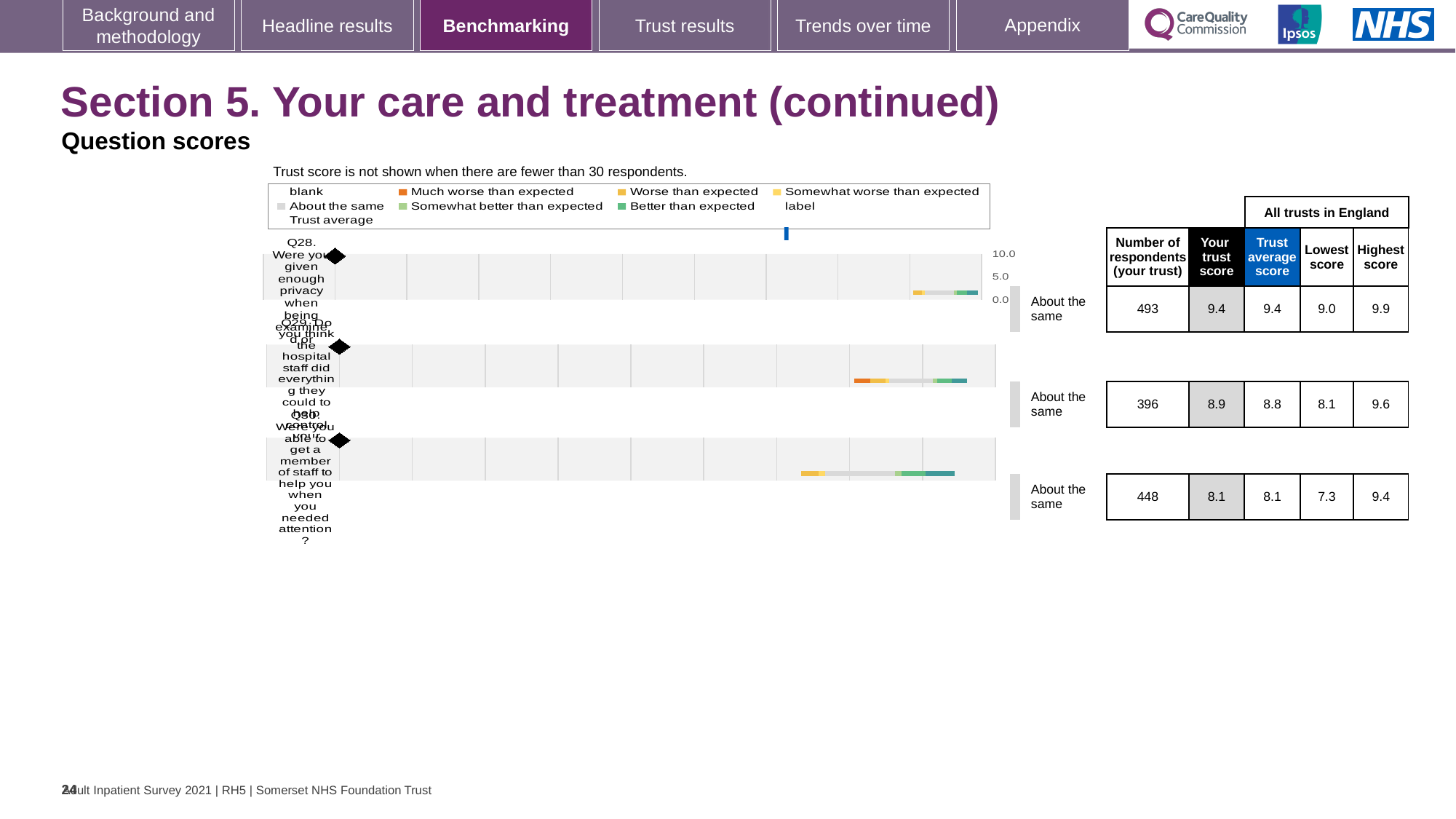
How many questions are plotted on this slide? 3 For Q29, which is larger: the 'Your trust score' or the 'Trust average score'? Your trust score What is the highest score across all trusts in England for Q30 (Were you able to get a member of staff to help you when you needed attention)? 9.4 Which question has the highest 'Your trust score' on this slide? Q28 Which question has the fewest respondents for your trust? Q29 What is the difference between the highest score and the lowest score for Q30? 2.1 How many respondents does the table show for Q29 (Do you think the hospital staff did everything they could to help control your pain)? 396 What is the lowest score across all trusts in England for Q28? 9.0 What is the 'Your trust score' value for Q28 (Were you given enough privacy when being examined or treated)? 9.4 What is the difference between the 'Your trust score' for Q28 and for Q30? 1.3 What kind of chart is used to show the question scores on this slide? Bar chart What benchmark category is shown for Q30? About the same